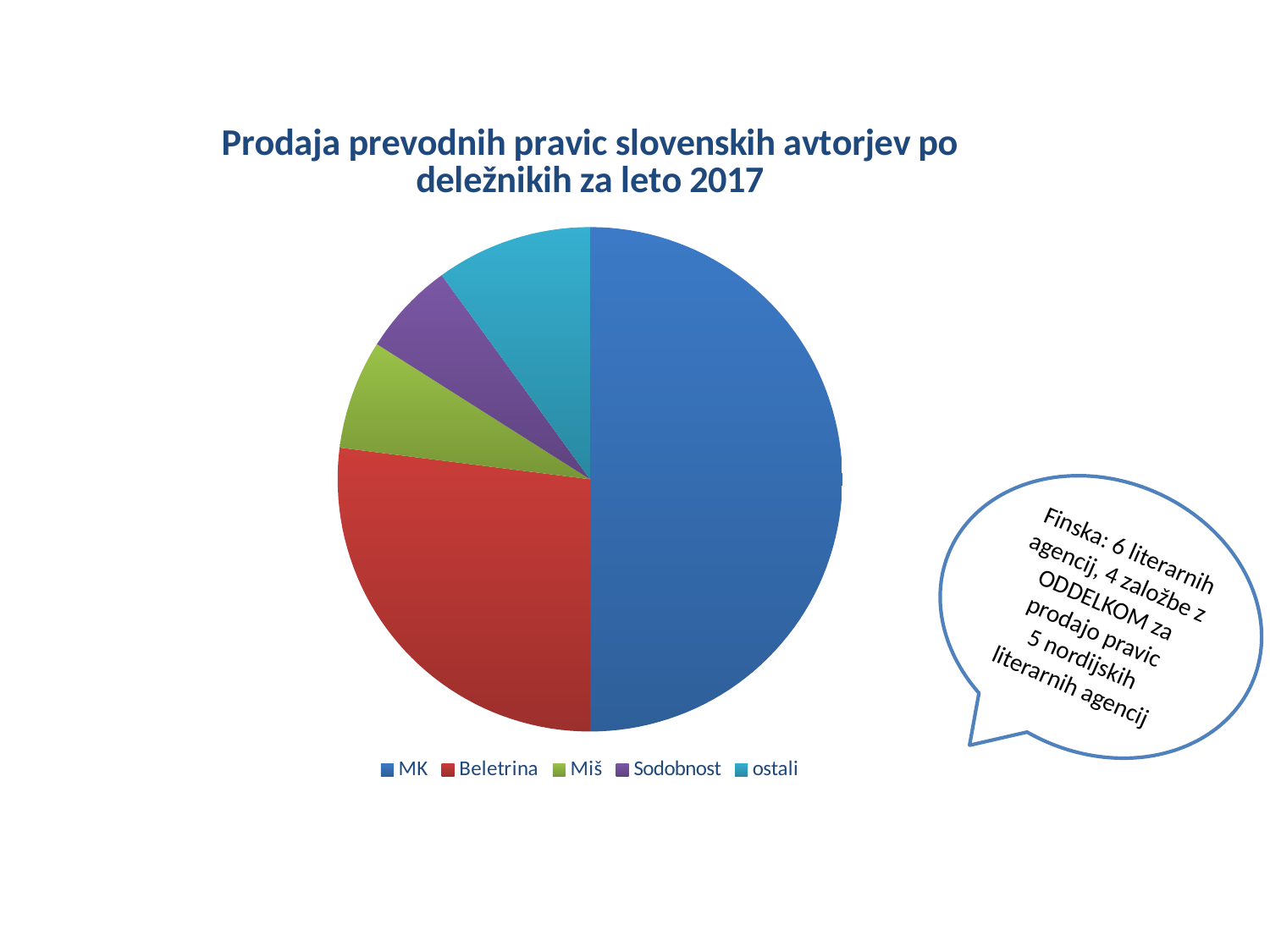
Which category has the largest slice of the pie chart? MK Which slice is larger, Beletrina or ostali? Beletrina Which slice is larger, ostali or Miš? ostali What kind of chart is shown on the slide? pie chart Which slice is larger, MK or Beletrina? MK What is the title of the pie chart? Prodaja prevodnih pravic slovenskih avtorjev po deležnikih za leto 2017 Which category is shown in red in the pie chart? Beletrina How many entries does the legend of the pie chart list? 5 How many slices does the pie chart have? 5